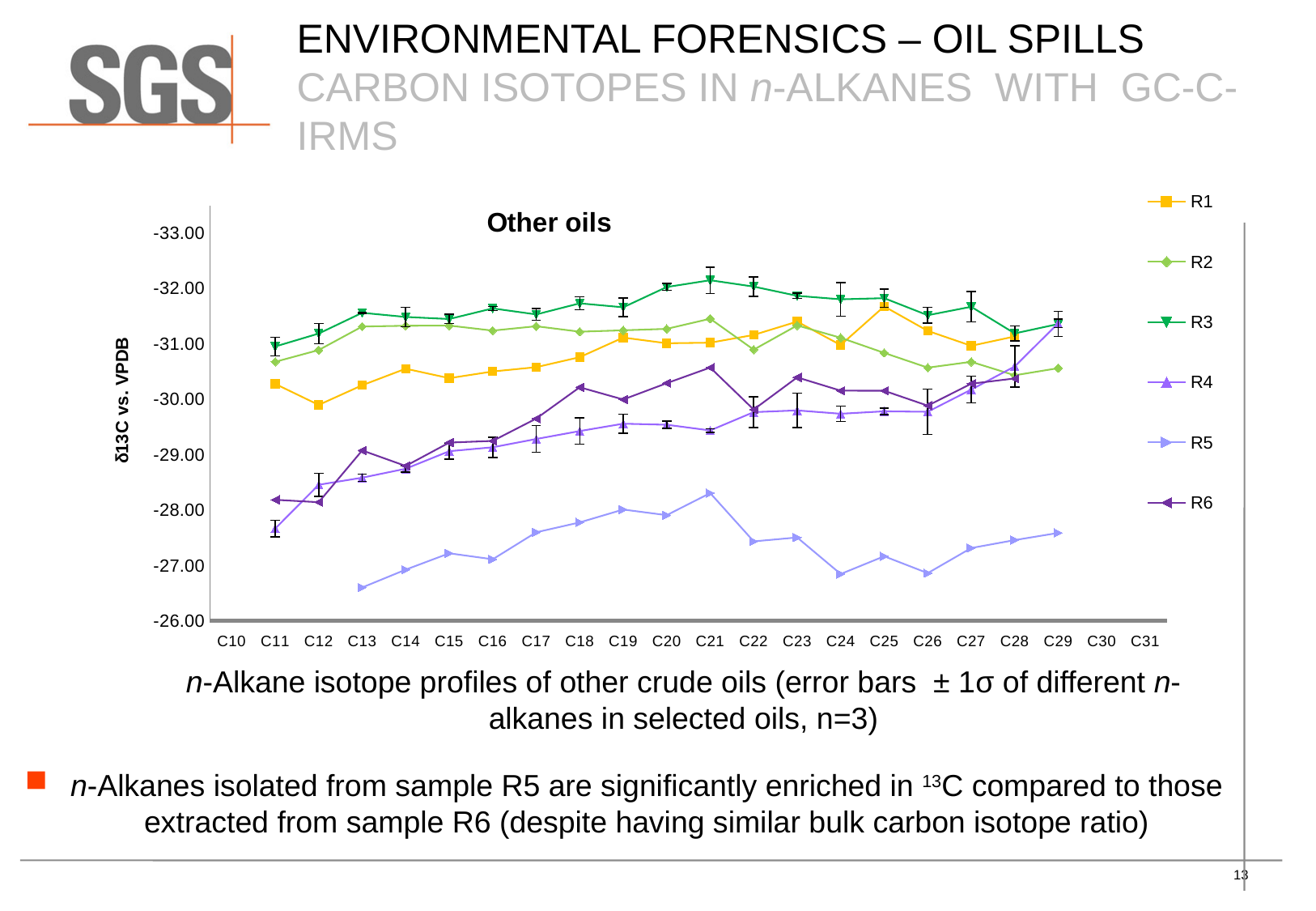
Is the value for R2 at C11 greater or less than -30.00? less Which series has the most negative δ13C values across the chart? R3 Which series has the least negative (highest) δ13C values across the chart? R5 What is the label of the y axis of the chart? δ13C vs. VPDB At C20, which series has the higher (less negative) value, R5 or R6? R5 What kind of chart is shown on the slide? line chart How many series does the legend of the chart list? 6 Is the value for R4 at C11 greater or less than -28.00? greater Is the value for R3 at C21 greater or less than -32.00? less What is the title of the chart? Other oils How many categories are labelled on the x axis of the chart? 22